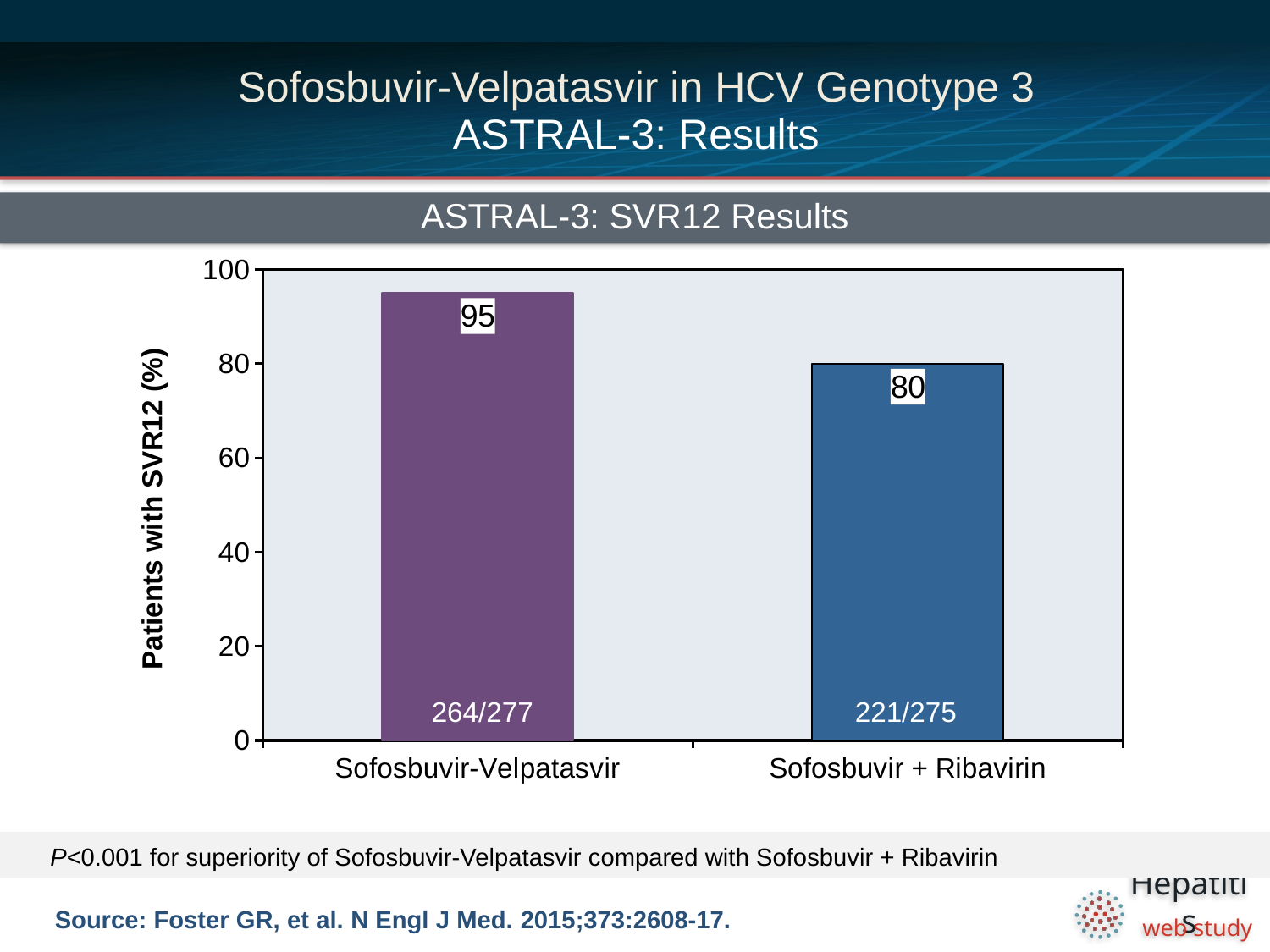
What fraction of patients is shown inside the Sofosbuvir-Velpatasvir bar? 264/277 Which treatment arm has the highest SVR12 rate? Sofosbuvir-Velpatasvir Which treatment arm has the lowest SVR12 rate? Sofosbuvir + Ribavirin What is the SVR12 rate for Sofosbuvir-Velpatasvir? 95 How many treatment arms are shown in the chart? 2 Is the value for Sofosbuvir + Ribavirin greater or less than 60? greater What is the title of the chart? ASTRAL-3: SVR12 Results What kind of chart is shown on the slide? bar chart What is the difference in SVR12 rate between Sofosbuvir-Velpatasvir and Sofosbuvir + Ribavirin? 15 What fraction of patients is shown inside the Sofosbuvir + Ribavirin bar? 221/275 What is the SVR12 rate for Sofosbuvir + Ribavirin? 80 Which has a larger SVR12 rate, Sofosbuvir-Velpatasvir or Sofosbuvir + Ribavirin? Sofosbuvir-Velpatasvir